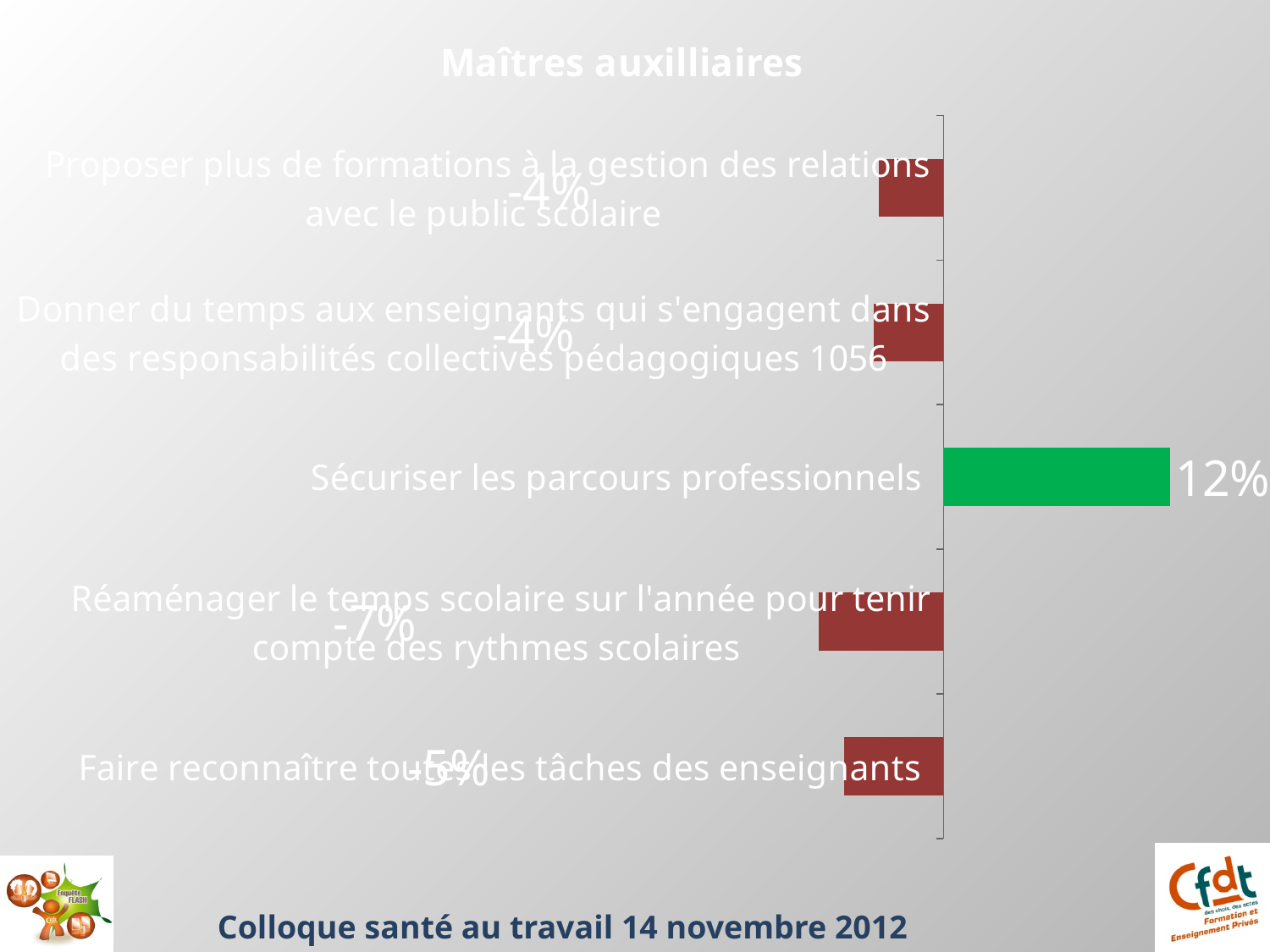
What is the title of the chart? Maîtres auxilliaires What is the difference between the value for "Sécuriser les parcours professionnels" and the value for "Réaménager le temps scolaire sur l'année pour tenir compte des rythmes scolaires"? 19 percentage points Which is larger: the value for "Faire reconnaître toutes les tâches des enseignants" or the value for "Réaménager le temps scolaire sur l'année pour tenir compte des rythmes scolaires"? Faire reconnaître toutes les tâches des enseignants Which category has the lowest value? Réaménager le temps scolaire sur l'année pour tenir compte des rythmes scolaires What is the value for "Proposer plus de formations à la gestion des relations avec le public scolaire"? -4% How many categories are shown in the chart? 5 What is the value for "Sécuriser les parcours professionnels"? 12% Which category has the highest value? Sécuriser les parcours professionnels What is the value for "Réaménager le temps scolaire sur l'année pour tenir compte des rythmes scolaires"? -7% How many bars in the chart have a positive value? 1 What kind of chart is shown on the slide? Bar chart What is the value for "Faire reconnaître toutes les tâches des enseignants"? -5%